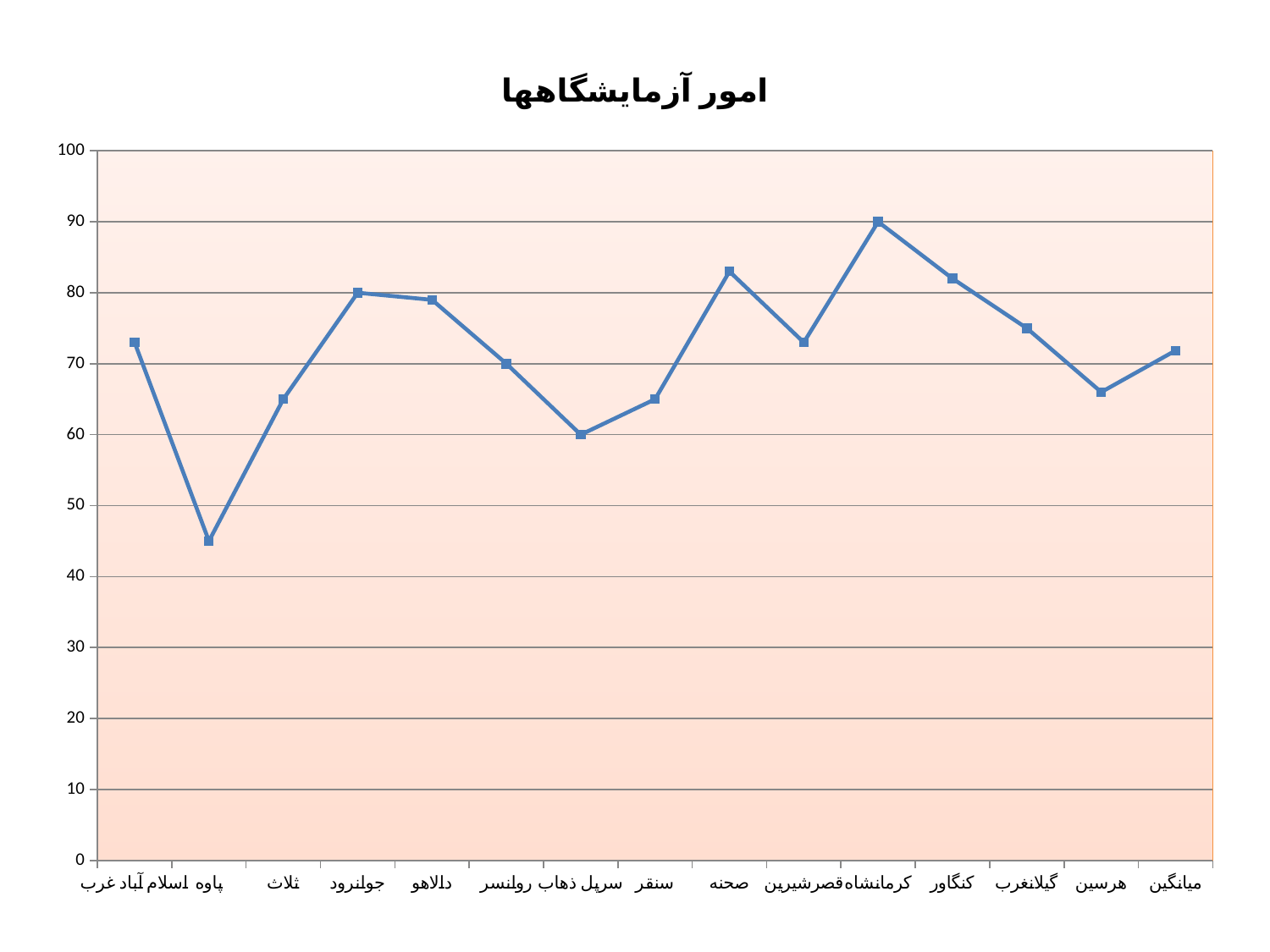
Which category has the lowest value? پاوه Is the value for پاوه greater or less than 50? less Is the value for هرسین greater or less than 70? less How many categories are plotted along the x axis? 15 Which is larger, the value for صحنه or the value for قصرشیرین? صحنه Which is larger, the value for کنگاور or the value for هرسین? کنگاور Is the value for صحنه greater or less than 80? greater What is the title of the chart? امور آزمایشگاهها What is the value for کرمانشاه? 90 Which category has the highest value? کرمانشاه What is the value for سرپل ذهاب? 60 What kind of chart is shown on the slide? line chart